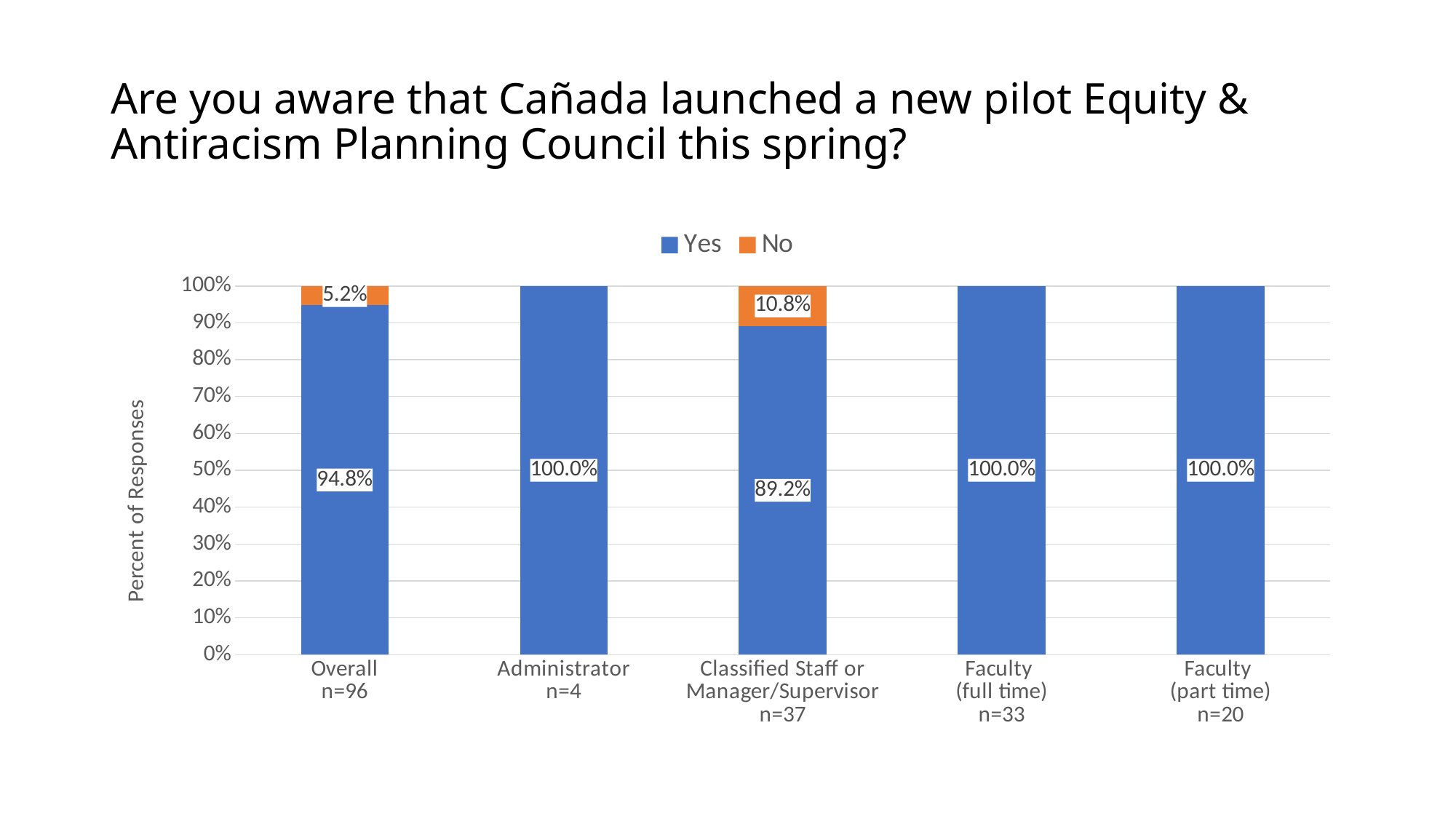
What percentage of Overall respondents answered Yes? 94.8% What is the difference between the Yes percentage for Overall and for Classified Staff or Manager/Supervisor? 5.6% What percentage of Classified Staff or Manager/Supervisor respondents answered No? 10.8% Which category has the highest No percentage? Classified Staff or Manager/Supervisor What percentage of Overall respondents answered No? 5.2% Is the Yes value for Classified Staff or Manager/Supervisor greater or less than 80%? greater What percentage of Faculty (part time) respondents answered Yes? 100.0% How many categories are shown on the x axis? 5 Which category has the lowest Yes percentage? Classified Staff or Manager/Supervisor How many series does the legend list? 2 Is the Yes percentage higher for Overall or for Classified Staff or Manager/Supervisor? Overall What kind of chart is shown on the slide? Stacked bar chart